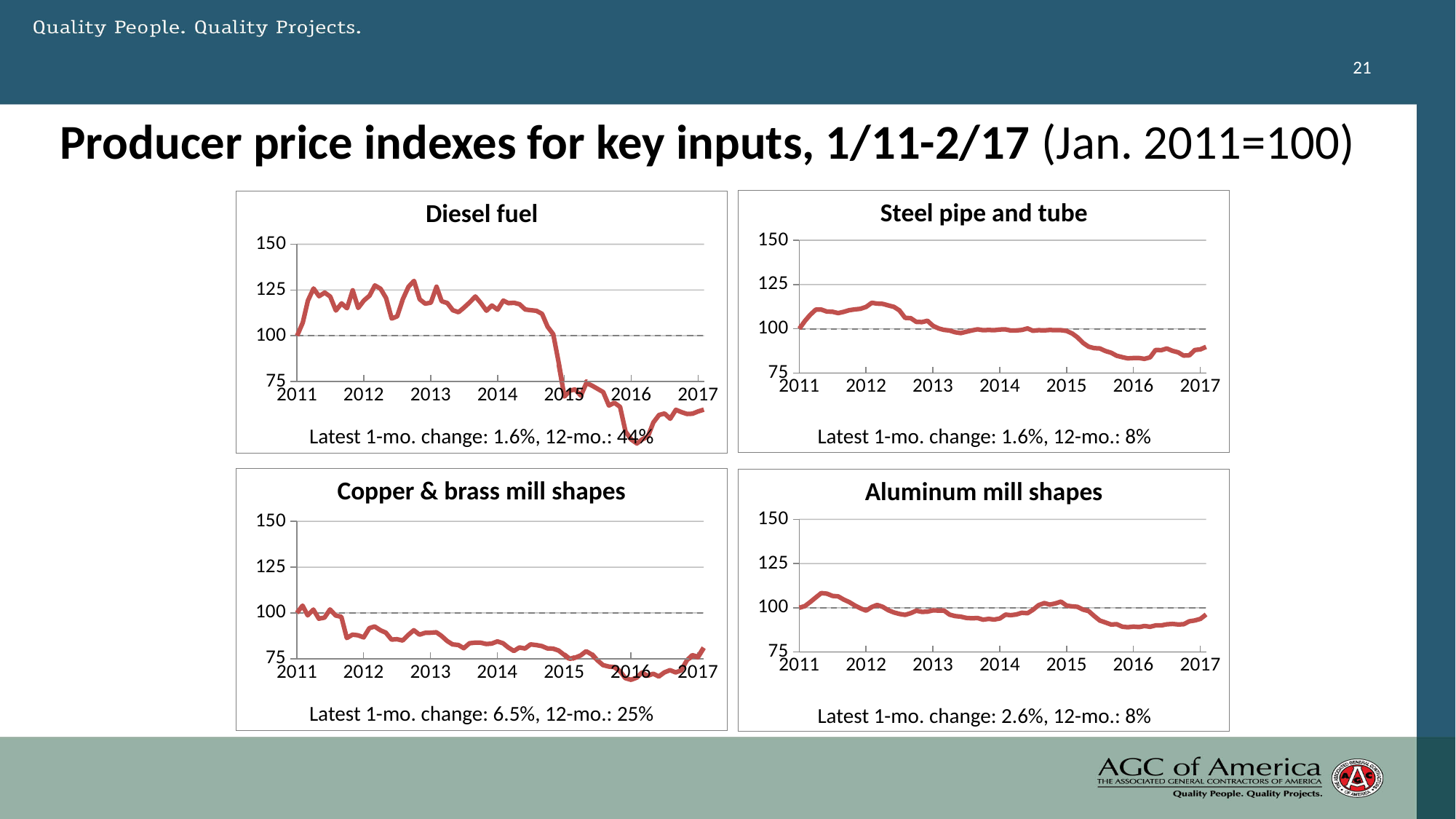
Which chart reports the larger latest 12-month change, Diesel fuel or Copper & brass mill shapes? Diesel fuel What kind of chart is the Diesel fuel chart? line chart In the Steel pipe and tube chart, is the value in 2016 greater or less than 100? less What is the title of the chart in the bottom right of the slide? Aluminum mill shapes How many charts are shown on the slide? 4 In the Copper & brass mill shapes chart, does the index generally rise or fall from 2011 to 2016? fall In the Steel pipe and tube chart, what is the latest 12-month change? 8% In the Copper & brass mill shapes chart, is the value in 2014 greater or less than 100? less In the Diesel fuel chart, is the value in early 2016 greater or less than 75? less In the Diesel fuel chart, what is the latest 12-month change? 44% In the Copper & brass mill shapes chart, what is the latest 1-month change? 6.5% In the Aluminum mill shapes chart, what is the latest 1-month change? 2.6%